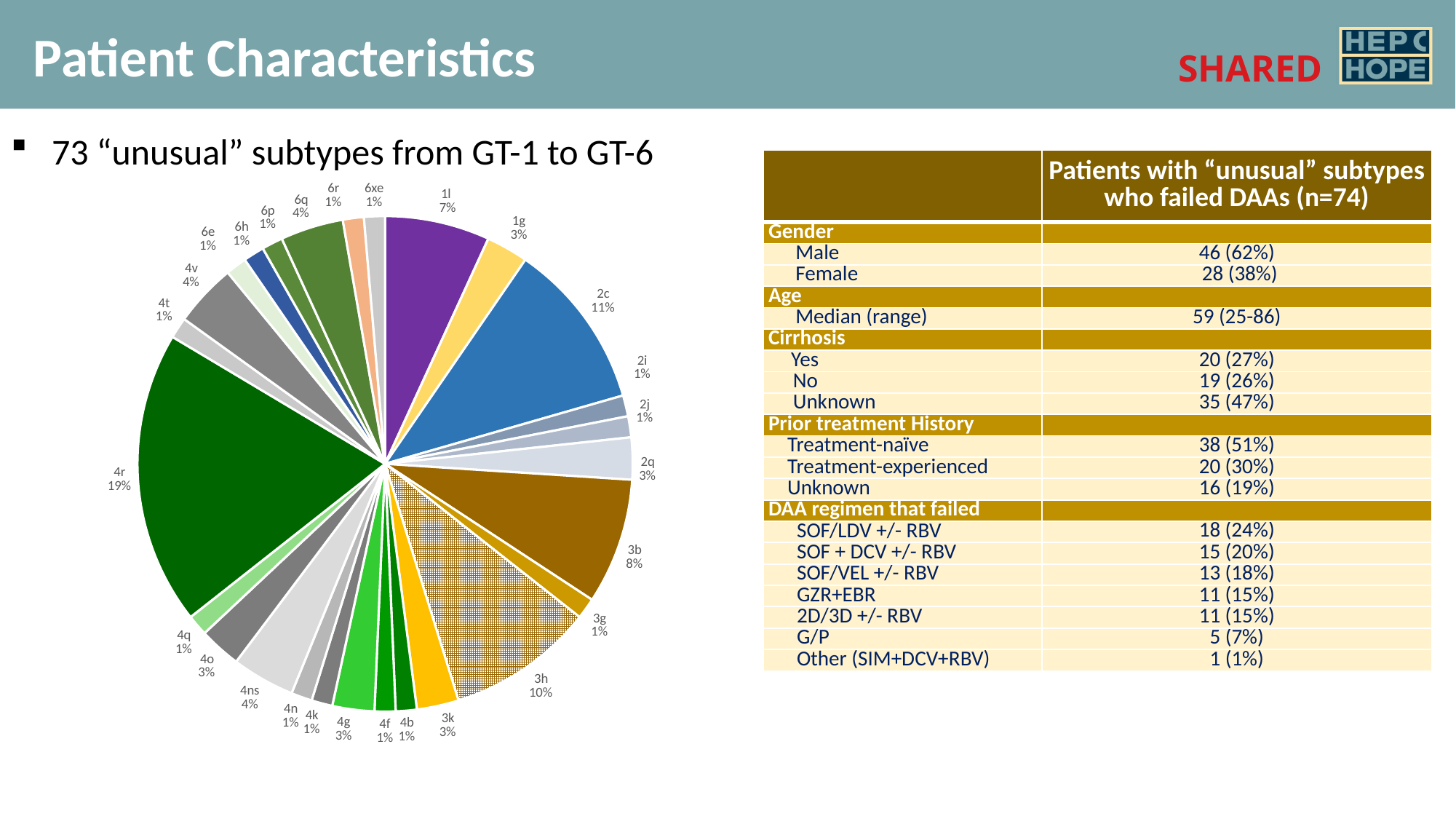
In the pie chart, what percentage is shown for subtype 4r? 19% What kind of chart is shown on the left of the slide? pie chart In the pie chart, what percentage is shown for subtype 1l? 7% In the pie chart, what percentage is shown for subtype 3h? 10% In the pie chart, what percentage is shown for subtype 3b? 8% In the pie chart, what is the difference in percentage points between the shares of 4r and 2c? 8 percentage points In the pie chart, what percentage is shown for subtype 2c? 11% In the pie chart, which has the larger share, 1l or 1g? 1l In the pie chart, which has the larger share, 2c or 3h? 2c In the pie chart, which subtype has the largest share? 4r In the pie chart, what share of the pie does subtype 3k represent? 3% In the pie chart, what percentage is shown for subtype 6q? 4%